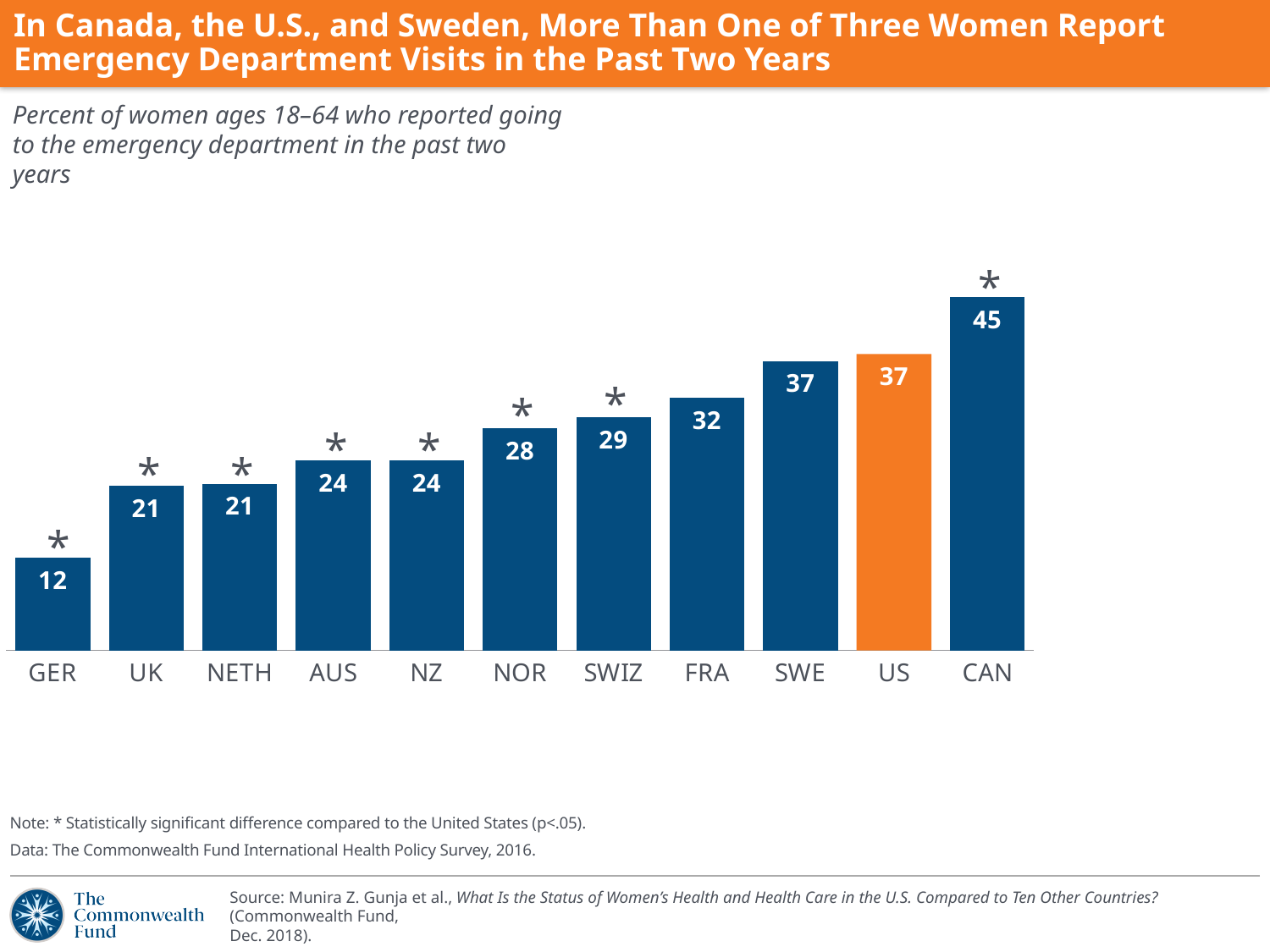
Which is larger, the value for FRA or the value for NZ? FRA Which country has the highest value? CAN What is the value for NOR? 28 What is the difference between the values for CAN and US? 8 Which country has the lowest value? GER Do the values rise or fall from left to right across the chart? Rise Which country's bar is coloured orange instead of blue? US What is the value for CAN? 45 What kind of chart is shown on the slide? Bar chart What is the value for GER? 12 How many countries are shown on the chart? 11 What is the difference between the values for SWIZ and GER? 17